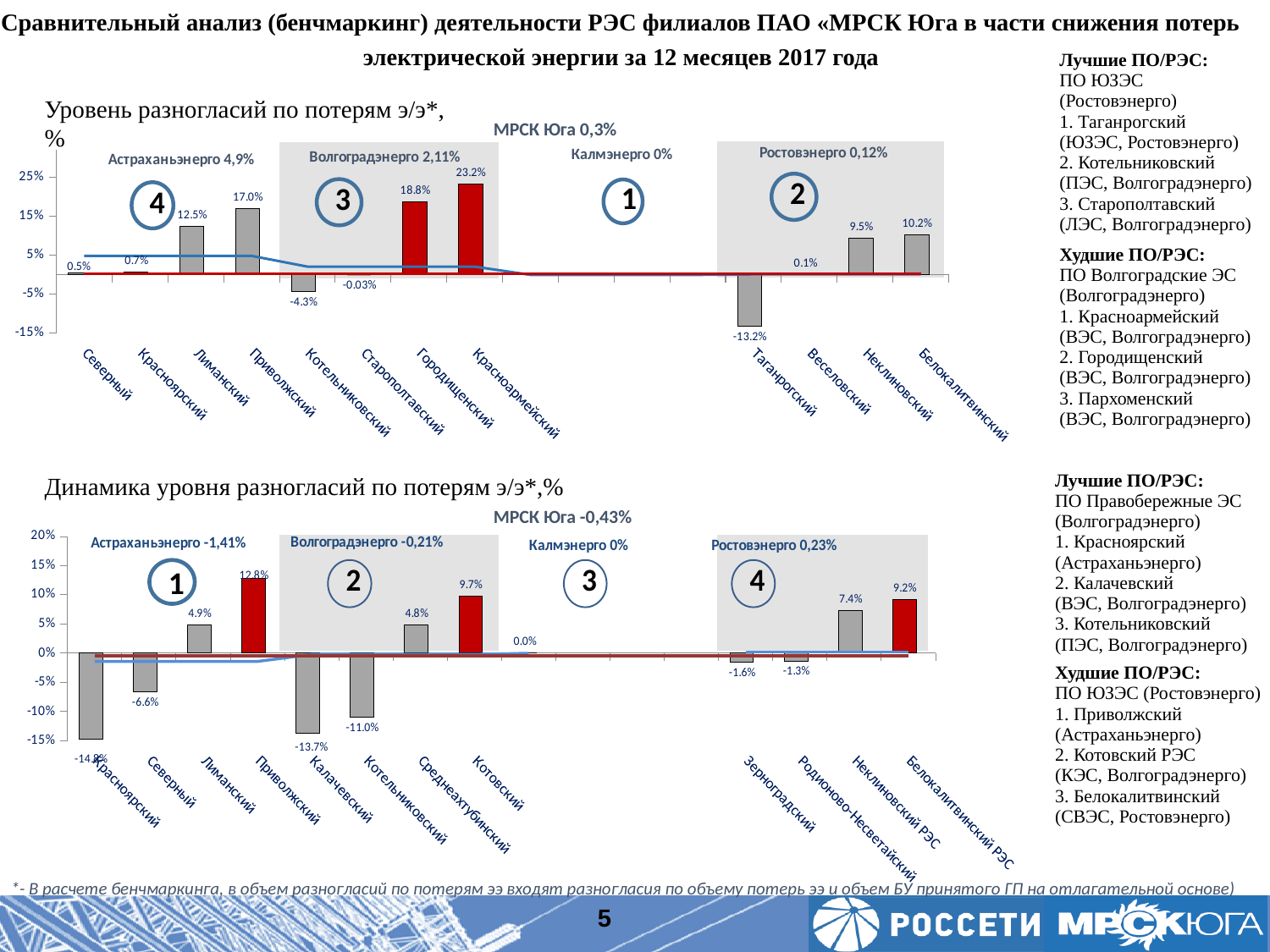
In the bottom chart 'Динамика уровня разногласий по потерям э/э', what is the difference between Котовский (9.7%) and Среднеахтубинский (4.8%)? 4.9% In the bottom chart 'Динамика уровня разногласий по потерям э/э', which category has the lowest value? Красноярский In the top chart 'Уровень разногласий по потерям э/э', which category has the highest value? Красноармейский In the top chart 'Уровень разногласий по потерям э/э', what is the value for Красноармейский? 23.2% In the top chart 'Уровень разногласий по потерям э/э', what is the value for Таганрогский? -13.2% In the bottom chart 'Динамика уровня разногласий по потерям э/э', what is the value for Приволжский? 12.8% What type of chart is the top chart 'Уровень разногласий по потерям э/э'? Combination bar and line chart In the bottom chart 'Динамика уровня разногласий по потерям э/э', which category has the highest value? Приволжский In the top chart 'Уровень разногласий по потерям э/э', which is larger: Неклиновский or Белокалитвинский? Белокалитвинский In the top chart 'Уровень разногласий по потерям э/э', what is the difference between Городищенский (18.8%) and Лиманский (12.5%)? 6.3% In the bottom chart 'Динамика уровня разногласий по потерям э/э', what is the value for Калачевский? -13.7% In the top chart 'Уровень разногласий по потерям э/э', which category has the lowest value? Таганрогский